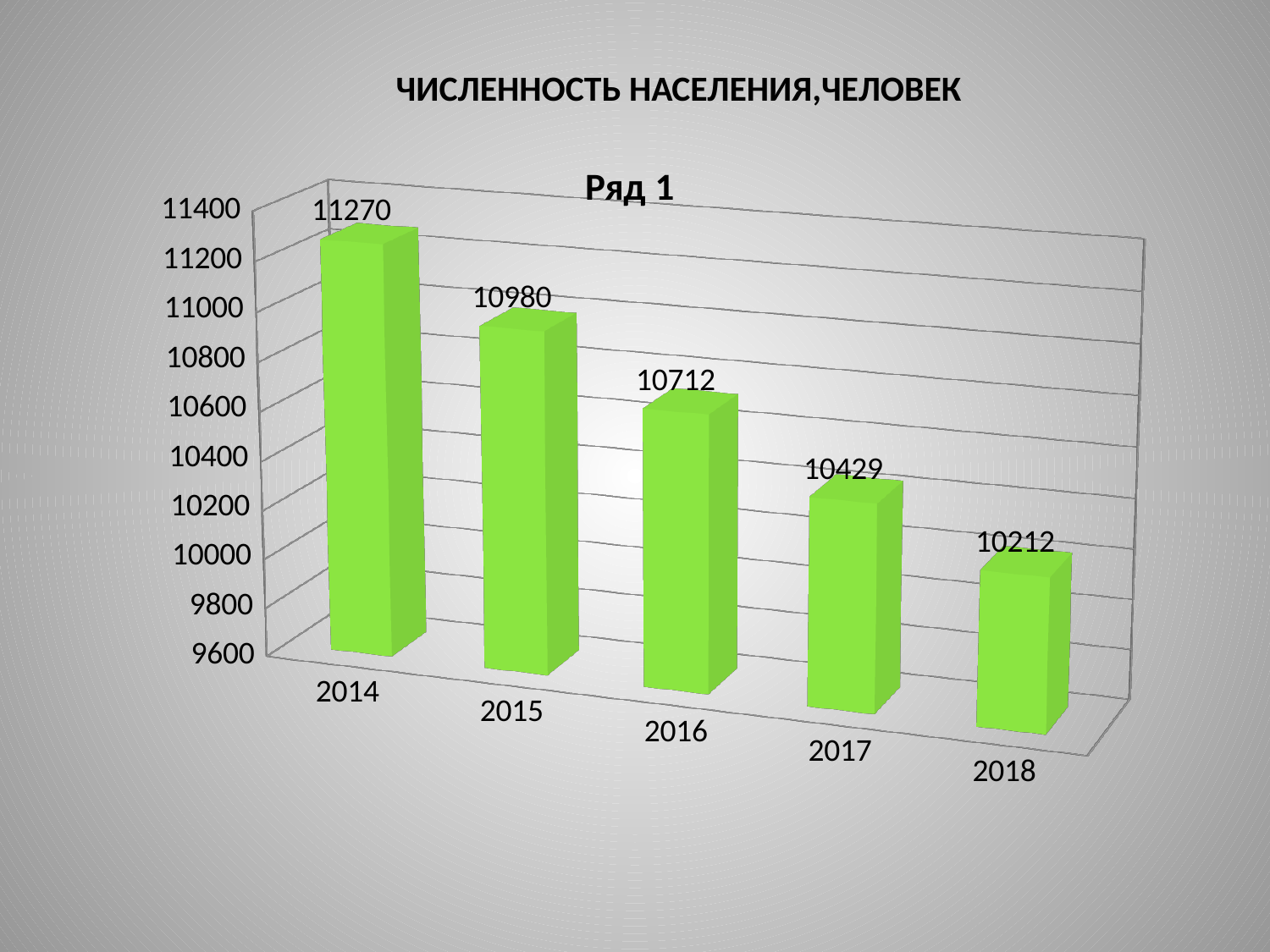
Do the values rise or fall from 2014 to 2018? fall What is the difference between the population values for 2015 and 2016? 268 Is the value for 2017 greater or less than 10600? less How many years are shown on the x axis? 5 Which year has the lowest population value? 2018 What is the population value shown for 2018? 10212 What is the difference between the population values for 2014 and 2018? 1058 Which is larger, the value for 2015 or the value for 2017? 2015 Which year has the highest population value? 2014 What kind of chart is shown on the slide? bar chart What is the population value shown for 2016? 10712 What is the population value shown for 2014? 11270